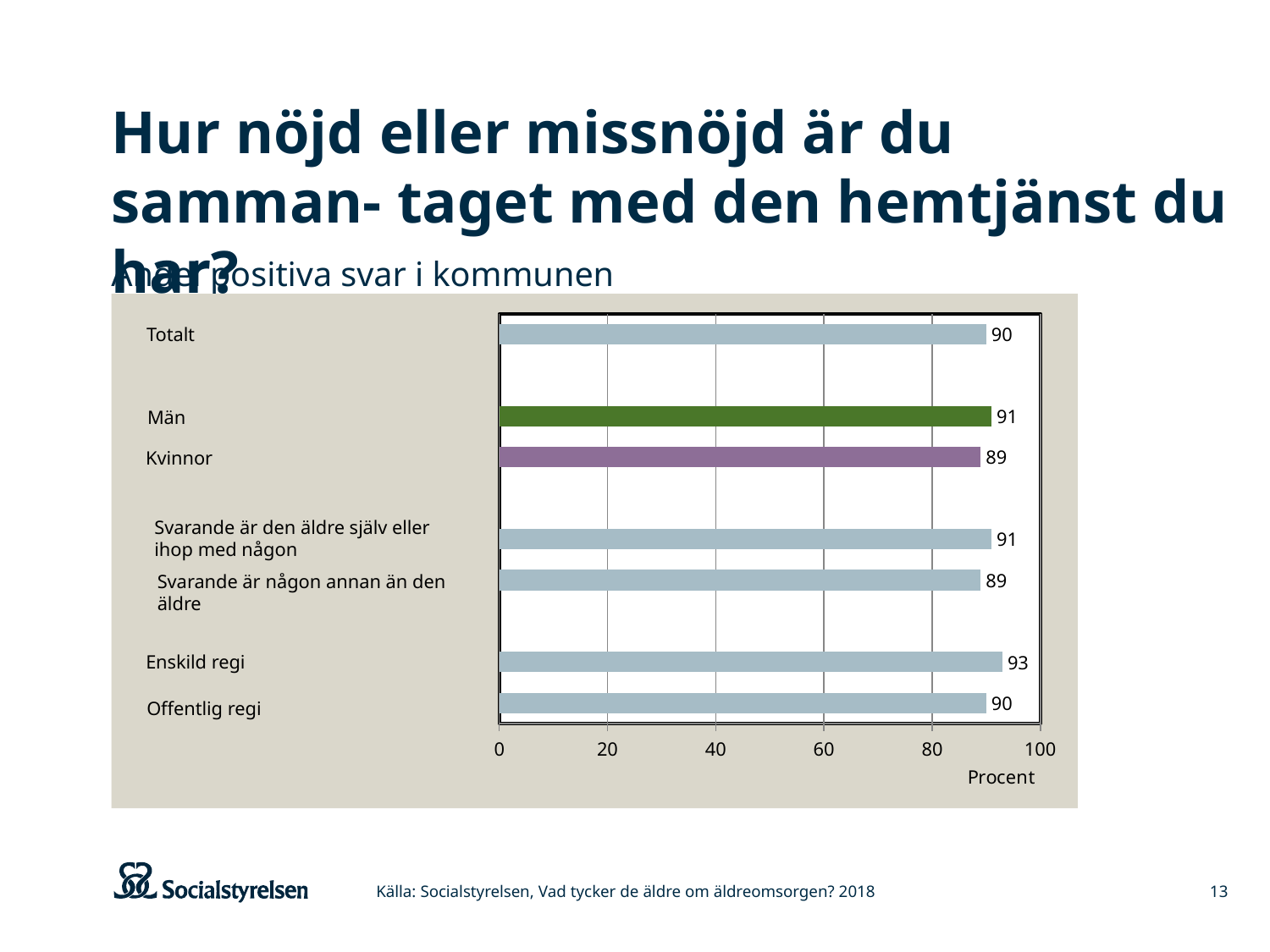
What kind of chart is shown on the slide? Bar chart What is the value for Totalt? 90 What is the value for Kvinnor? 89 What is the value for Män? 91 What is the difference between the values for Enskild regi and Offentlig regi? 3 What is the difference between the values for Män and Kvinnor? 2 What is the value for Enskild regi? 93 Which is larger, the value for Män or the value for Kvinnor? Män What is the label of the x axis? Procent How many categories are shown in the chart? 7 What is the value for Offentlig regi? 90 Which category has the highest value? Enskild regi